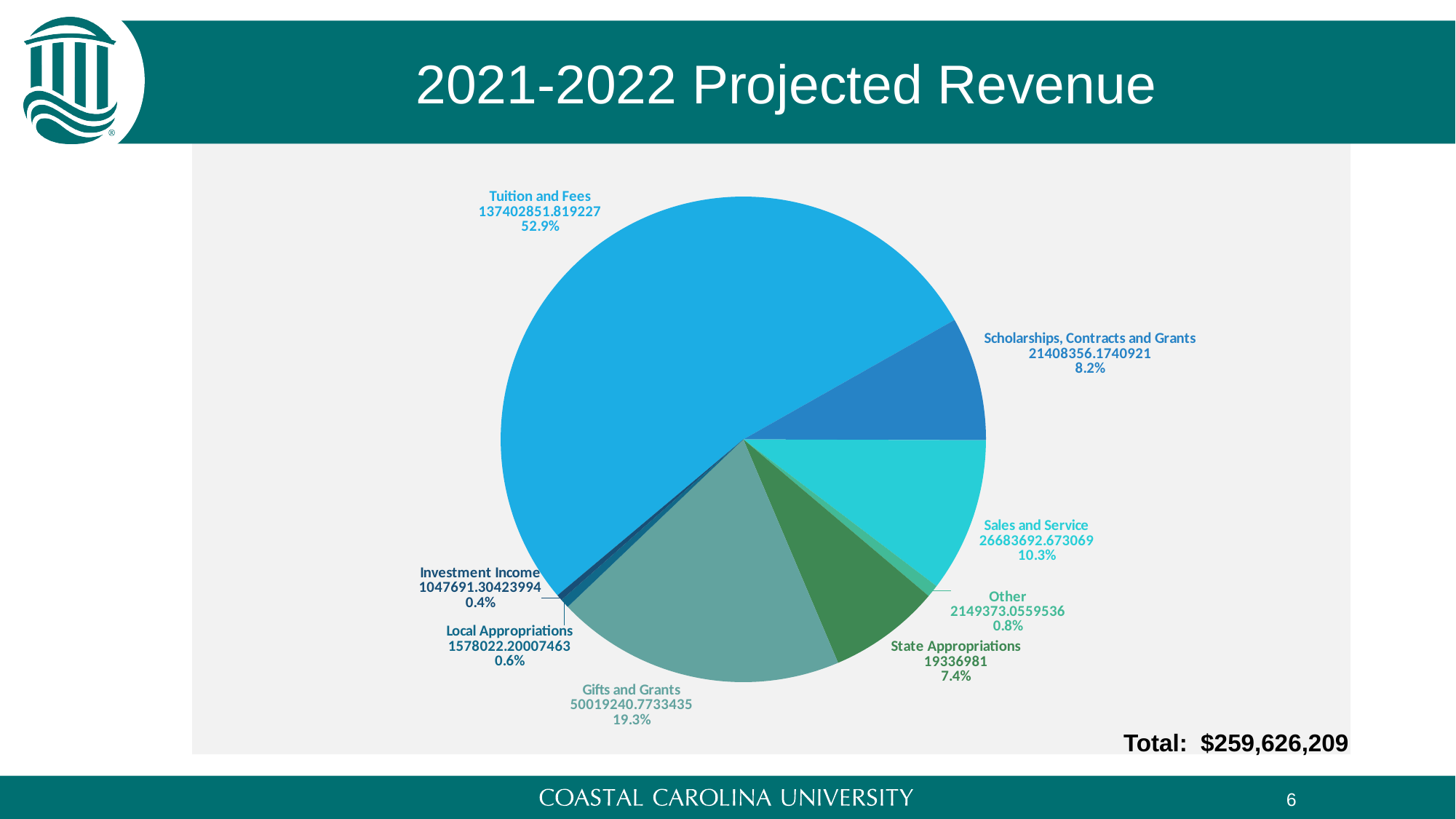
What is the title of the slide? 2021-2022 Projected Revenue What percentage share does Gifts and Grants have? 19.3% What is the difference in percentage share between Tuition and Fees and Gifts and Grants? 33.6 percentage points What is the projected revenue value for State Appropriations? 19336981 What kind of chart is shown on the slide? pie chart What percentage share does Tuition and Fees have? 52.9% Which is larger, Sales and Service or Scholarships, Contracts and Grants? Sales and Service Which category has the largest share of projected revenue? Tuition and Fees What total is printed below the chart? $259,626,209 How many slices does the pie chart have? 8 What is the projected revenue value for Sales and Service? 26683692.673069 Which category has the smallest share of projected revenue? Investment Income